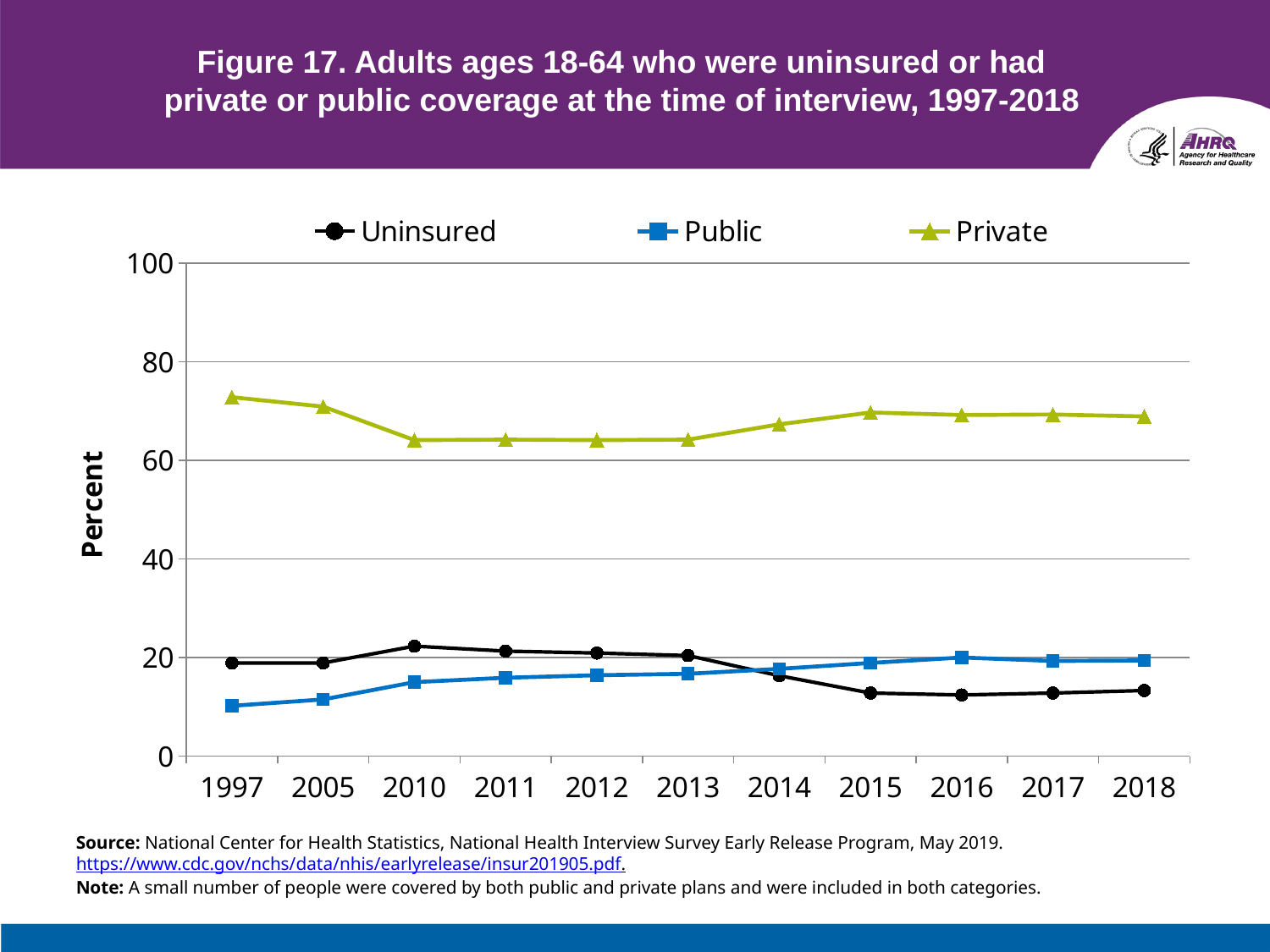
Is the value for Public in 1997 greater or less than 20? less In 2018, which is larger: the Public value or the Uninsured value? Public What kind of chart is shown on the slide? Line chart Which series has the highest values across all years shown? Private How many years are plotted along the x axis? 11 How many series does the legend list? 3 Does the Public series rise or fall from 1997 to 2018? Rise Is the value for Private in 1997 greater or less than 60? greater In 1997, which is larger: the Public value or the Uninsured value? Uninsured Is the value for Uninsured in 2018 greater or less than 20? less What is the label on the y axis? Percent In which year is the Public series at its lowest? 1997